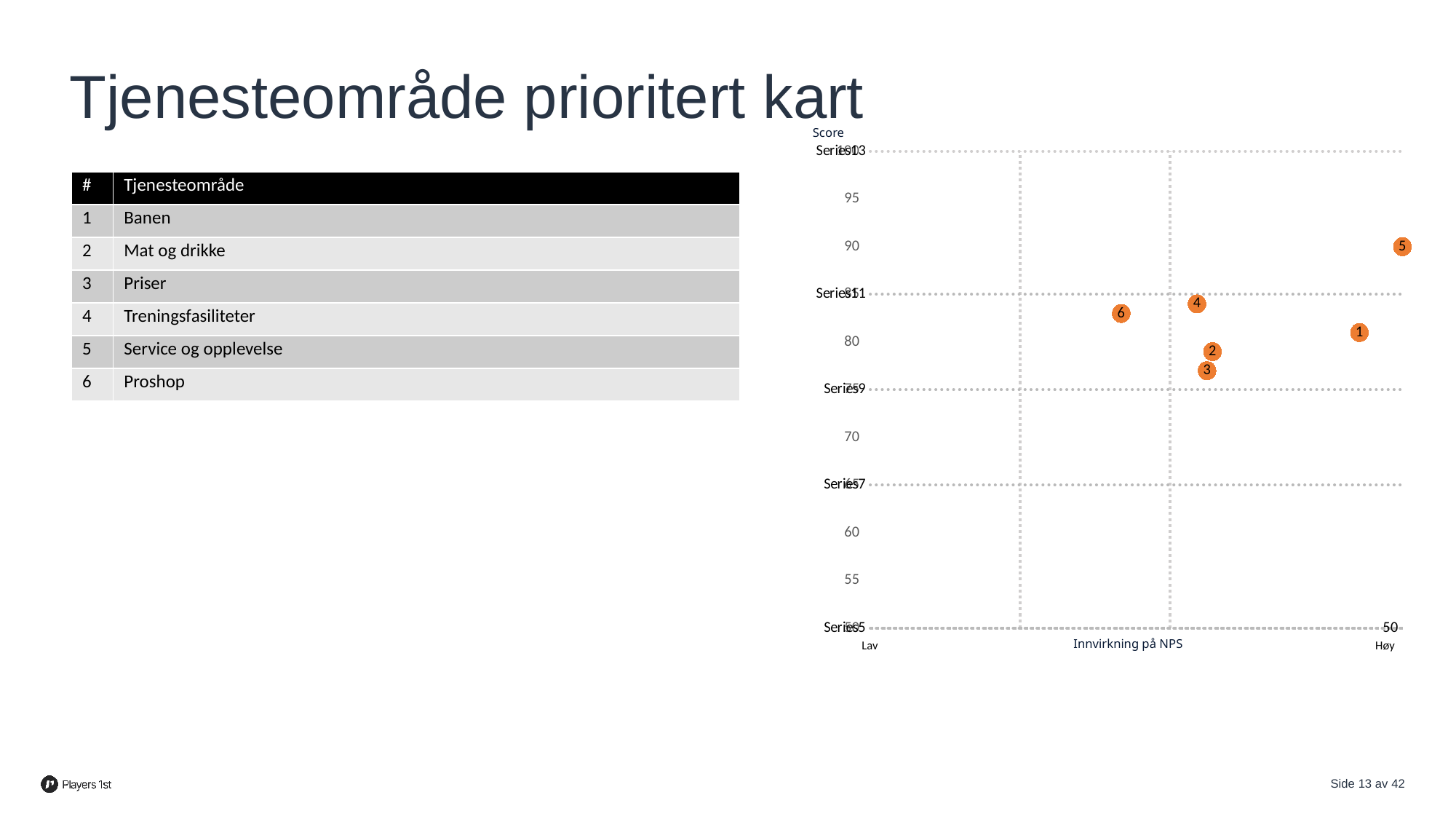
How many numbered points are plotted on the chart? 6 Is the score for point 4 greater or less than 90? less Which has the higher score, point 1 or point 3? point 1 Which numbered point has the lowest score on the chart? 3 Which numbered point has the highest score on the chart? 5 Is the score for point 5 greater or less than 85? greater Which numbered point is placed furthest to the right (highest 'Innvirkning på NPS')? 5 Is the score for point 6 greater or less than 80? greater Which has the higher score, point 5 or point 1? point 5 What kind of chart is shown on the slide? scatter chart What is the title of the vertical axis of the chart? Score